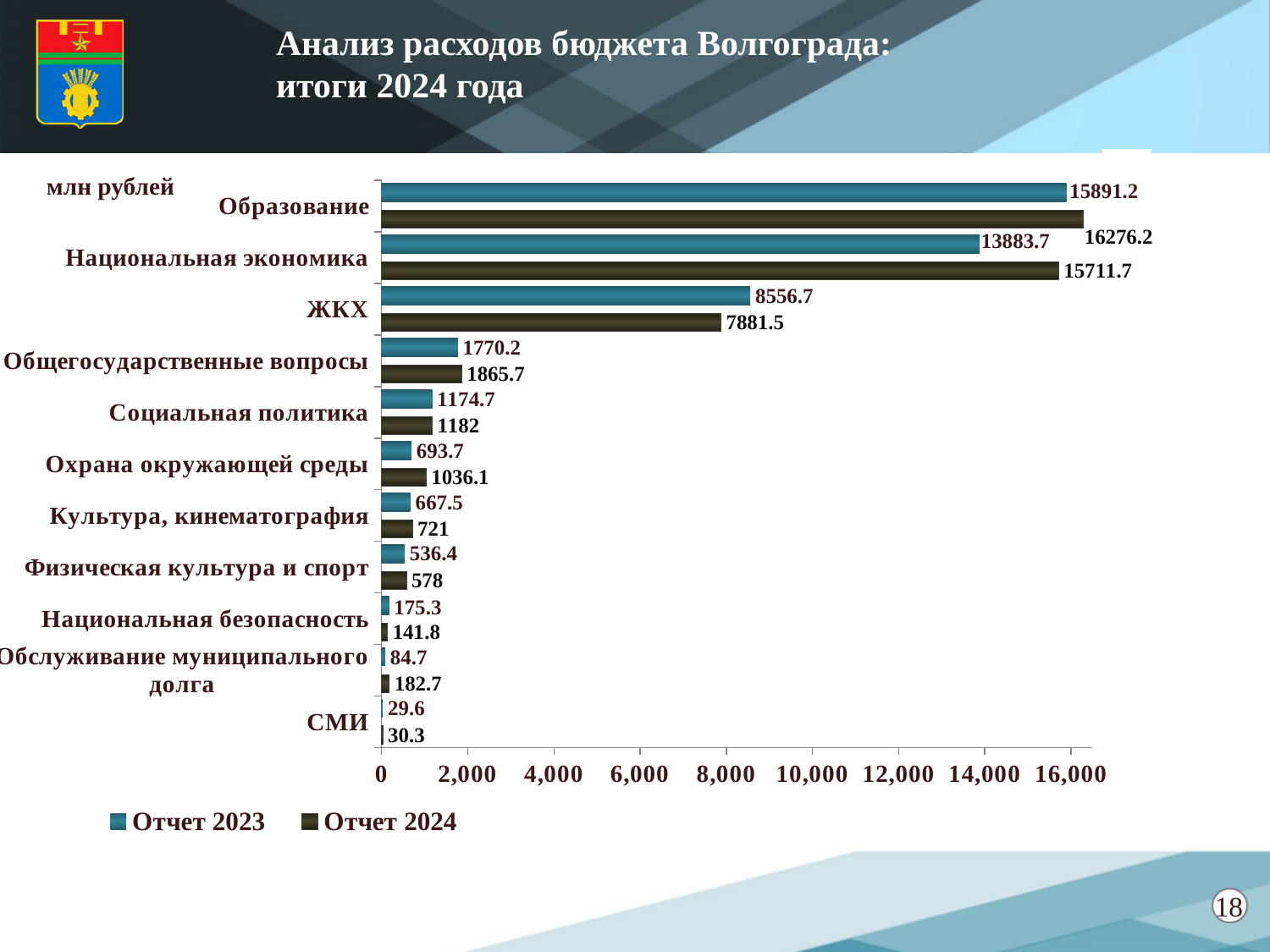
Which category has the highest value in the Отчет 2024 series? Образование What is the value for Образование in the Отчет 2024 series? 16276.2 How many series does the legend list? 2 What is the value for Охрана окружающей среды in the Отчет 2024 series? 1036.1 What is the difference between the Отчет 2024 and Отчет 2023 values for Национальная экономика? 1828 For Обслуживание муниципального долга, which series has the larger value, Отчет 2023 or Отчет 2024? Отчет 2024 For ЖКХ, which series has the larger value, Отчет 2023 or Отчет 2024? Отчет 2023 What is the value for ЖКХ in the Отчет 2023 series? 8556.7 Which category has the lowest value in the Отчет 2023 series? СМИ What kind of chart is shown on the slide? Bar chart What is the value for СМИ in the Отчет 2023 series? 29.6 How many categories are shown on the chart? 11